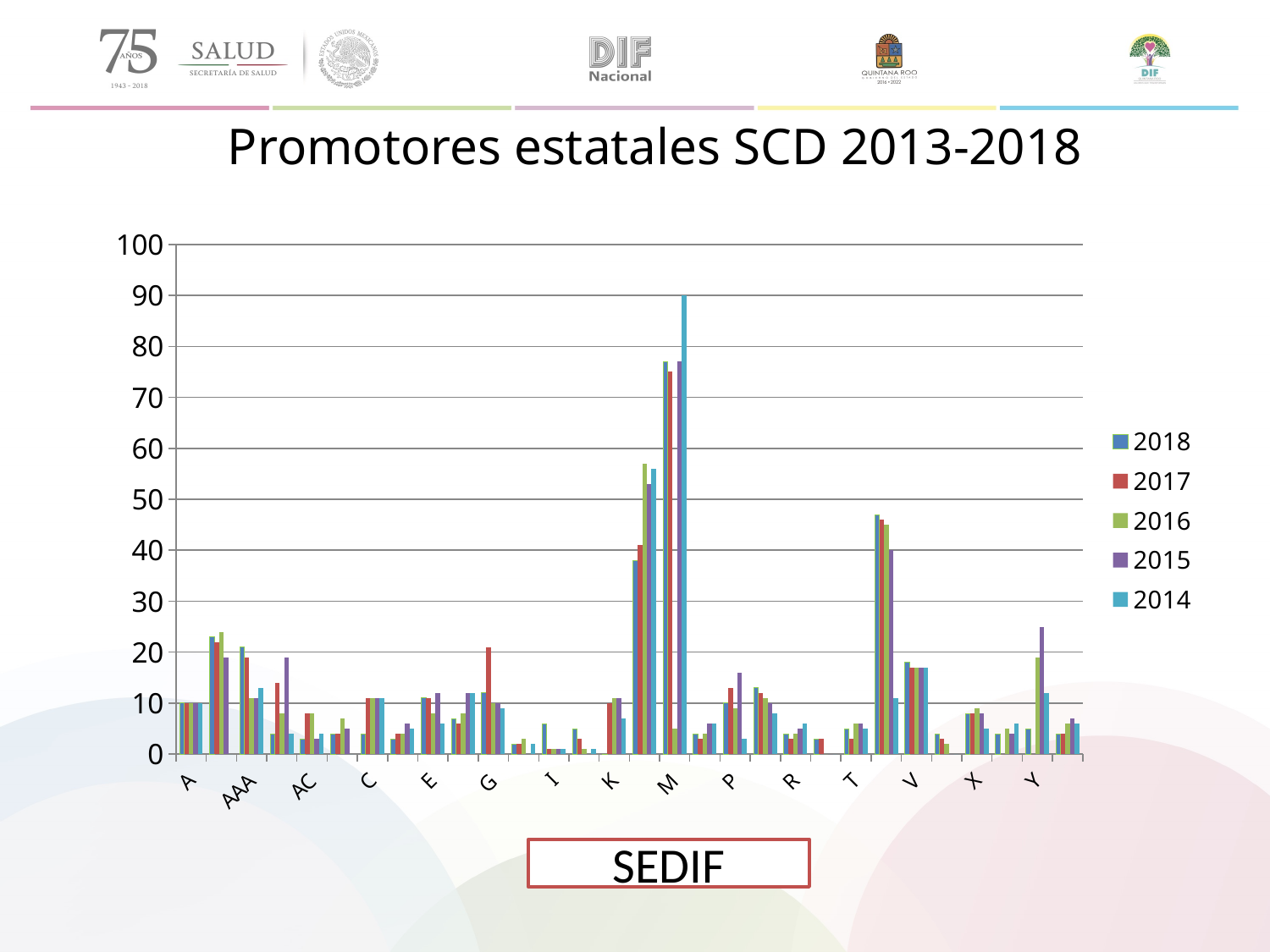
Which category on the x axis has the tallest bar in the chart? M Is the 2014 value for M greater or less than 80? greater Which years are listed in the chart legend? 2018, 2017, 2016, 2015, 2014 Which series has the shortest bar in category M? 2016 Is the 2015 value for Y greater or less than 20? greater What kind of chart is shown on the slide? Bar chart For the 2017 series, which is larger: the value for M or the value for V? M What is the title of the chart? Promotores estatales SCD 2013-2018 How many series does the legend list? 5 Is the 2018 value for V greater or less than 40? less Which series has the tallest bar in category M? 2014